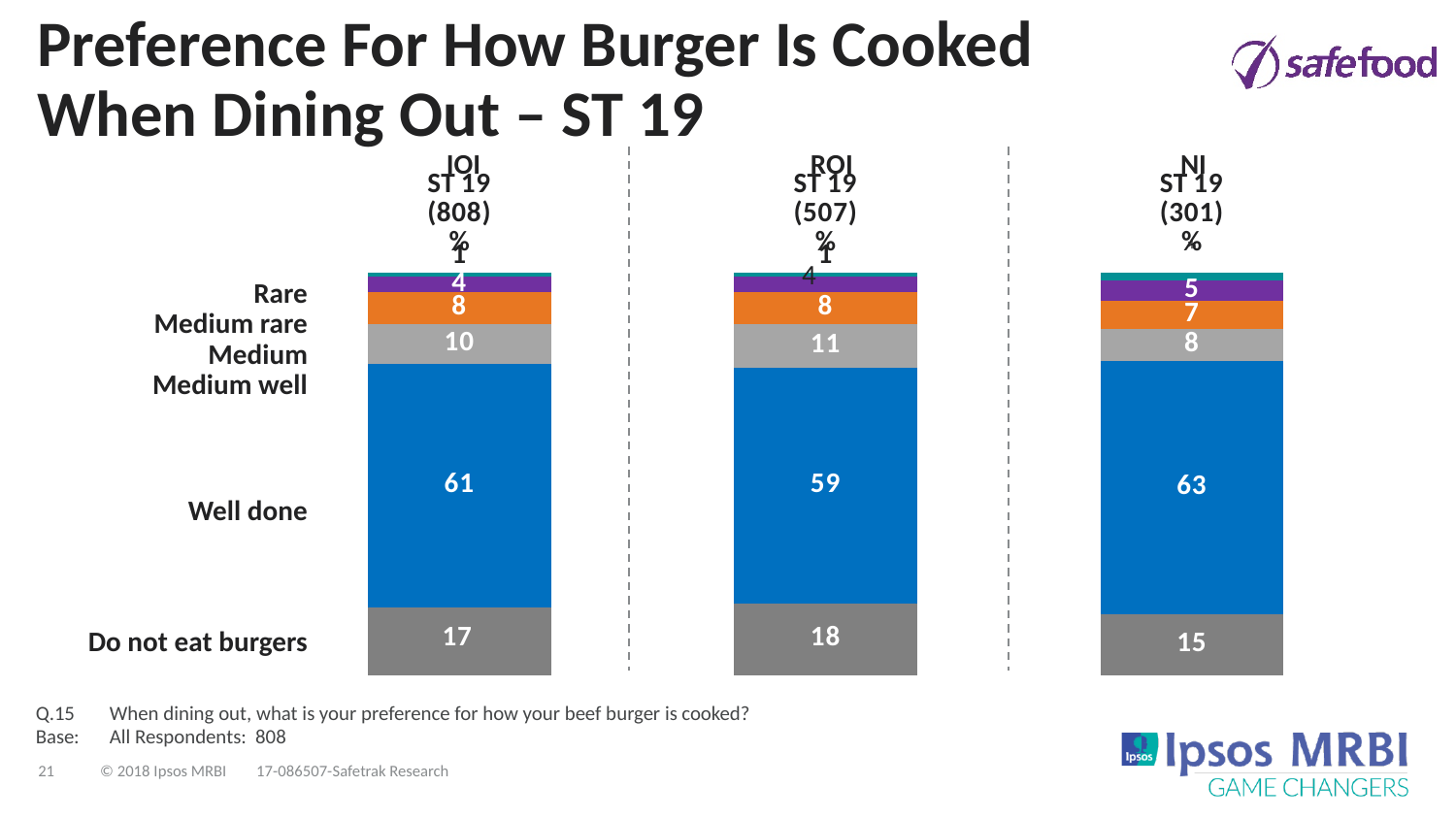
What is the base size shown for the ROI ST 19 chart? 507 What is the difference between the well done percentages in the IOI ST 19 chart and the ROI ST 19 chart? 2 Across the three charts, which region has the highest percentage preferring well done burgers? NI In the ROI ST 19 chart, what percentage prefer their burger well done? 59 What type of chart is used on this slide? Stacked bar chart Which is larger: the 'Do not eat burgers' percentage in the ROI ST 19 chart or in the NI ST 19 chart? ROI In the NI ST 19 chart, what percentage do not eat burgers? 15 In the NI ST 19 chart, what percentage prefer their burger well done? 63 In the ROI ST 19 chart, what percentage prefer their burger medium well? 11 In the NI ST 19 chart, what percentage prefer their burger medium? 7 In the IOI ST 19 chart, which preference category has the largest share? Well done In the IOI ST 19 chart, what percentage prefer their burger well done? 61